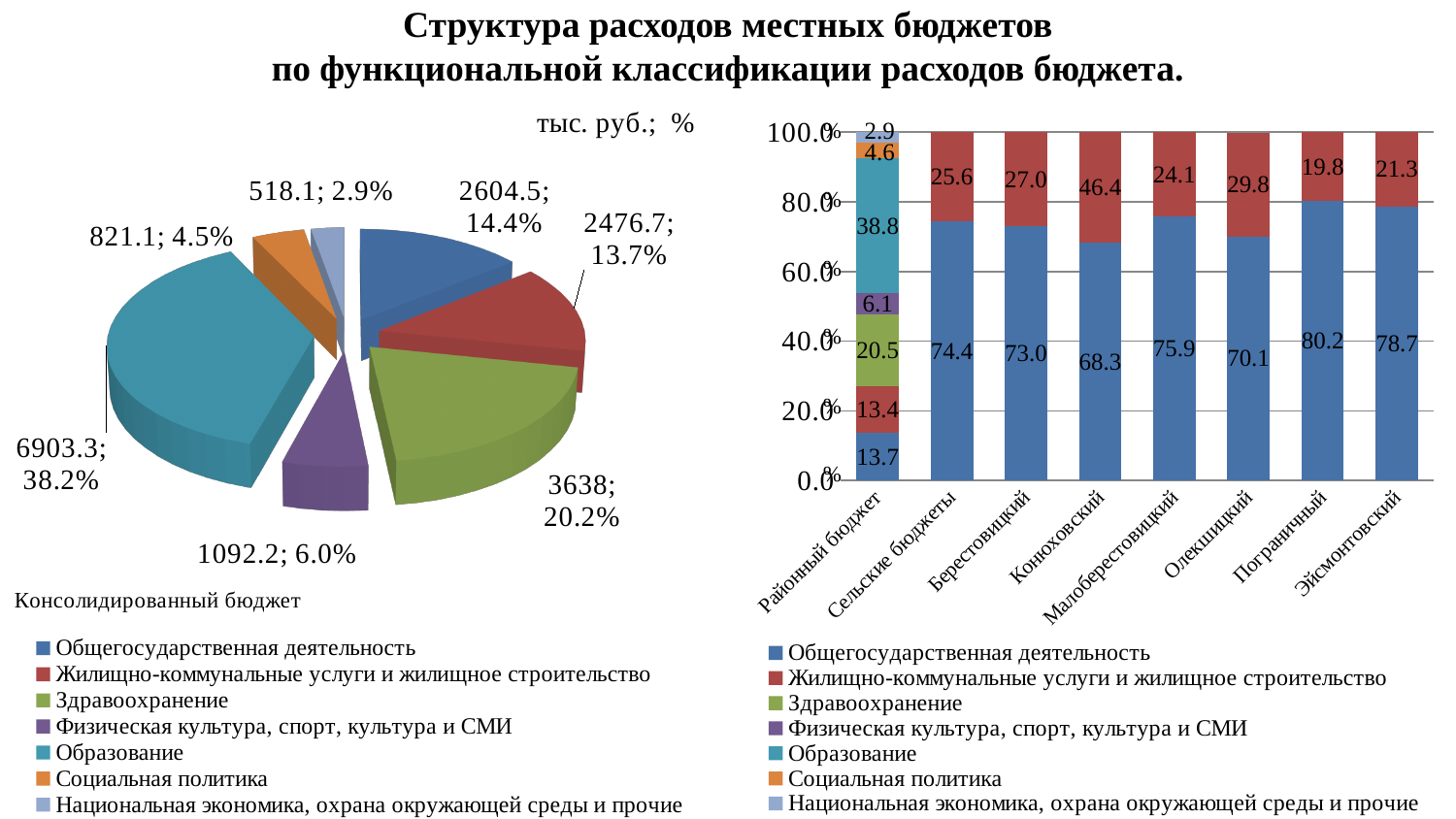
In the pie chart on the left, what share of the total does Здравоохранение have? 20.2% In the pie chart on the left, which category has the smallest slice? Национальная экономика, охрана окружающей среды и прочие How many series does the legend of the bar chart on the right list? 7 How many categories are shown on the x axis of the bar chart on the right? 8 In the bar chart on the right, what is the value of Общегосударственная деятельность for Пограничный? 80.2 In the bar chart on the right, which category has the highest value for Общегосударственная деятельность? Пограничный In the bar chart on the right, what is the difference between Общегосударственная деятельность and Жилищно-коммунальные услуги и жилищное строительство for Сельские бюджеты? 48.8 How many slices does the pie chart on the left have? 7 What kind of chart is the chart on the right of the slide? Stacked bar chart In the pie chart on the left (Консолидированный бюджет), what value and share are shown for Образование? 6903.3; 38.2% In the bar chart on the right, what is the value of Образование for Районный бюджет? 38.8 In the pie chart on the left, which category has the largest slice? Образование